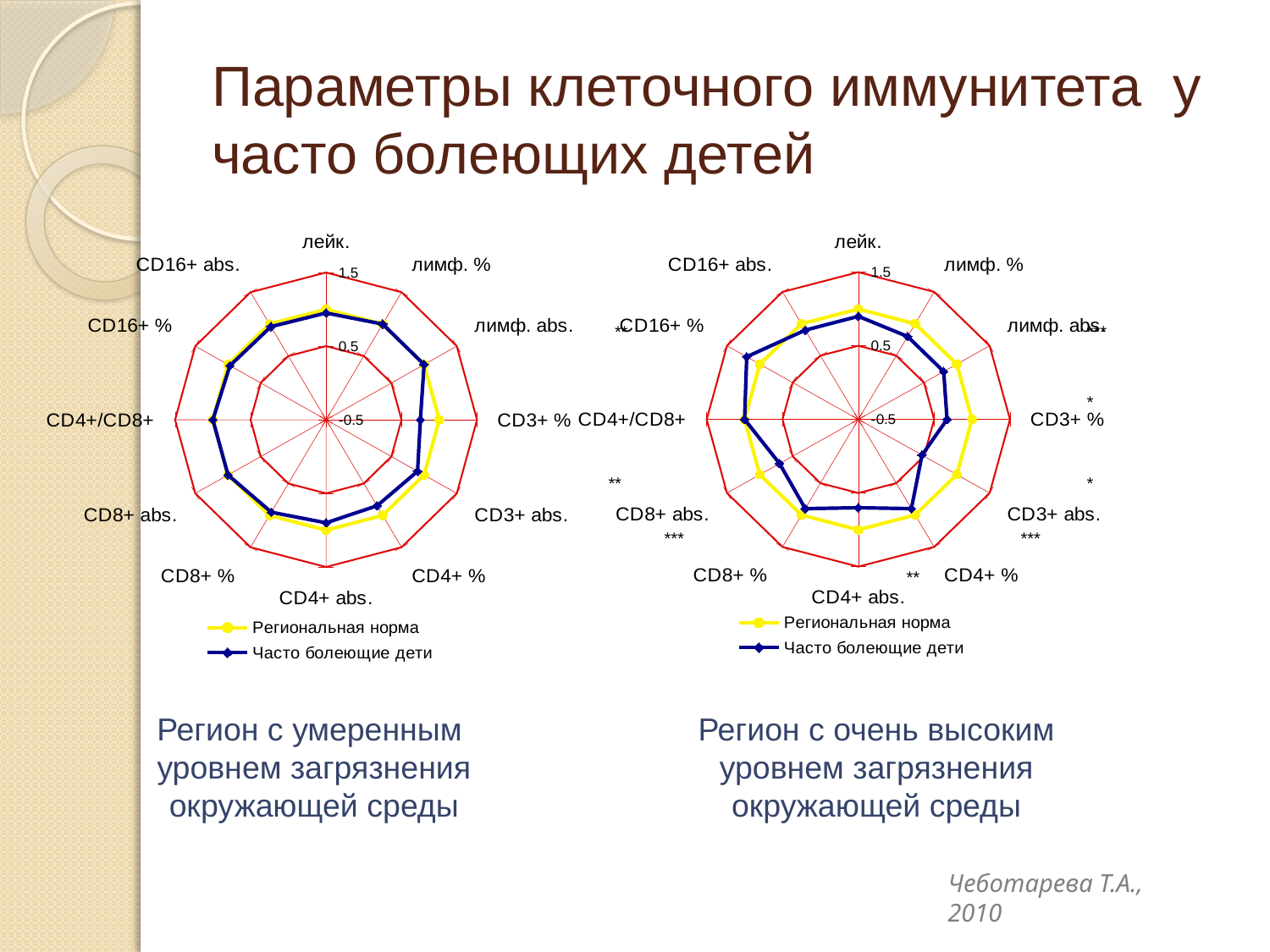
Which series is drawn in yellow in both charts? Региональная норма How many charts are shown on the slide? 2 In the right chart (Регион с очень высоким уровнем загрязнения), which series has the larger value for CD16+ %: Региональная норма or Часто болеющие дети? Часто болеющие дети In the left chart (Регион с умеренным уровнем загрязнения), which series has the larger value for CD3+ %: Региональная норма or Часто болеющие дети? Региональная норма How many series does the legend of the left chart (Регион с умеренным уровнем загрязнения) list? 2 What kind of chart is used on this slide for both regions? Radar chart In the left chart (Регион с умеренным уровнем загрязнения), which series has the larger value for CD4+ abs.: Региональная норма or Часто болеющие дети? Региональная норма How many categories (axes) does the right chart (Регион с очень высоким уровнем загрязнения) have? 12 What is the highest tick value shown on the radial axis of the left chart? 1.5